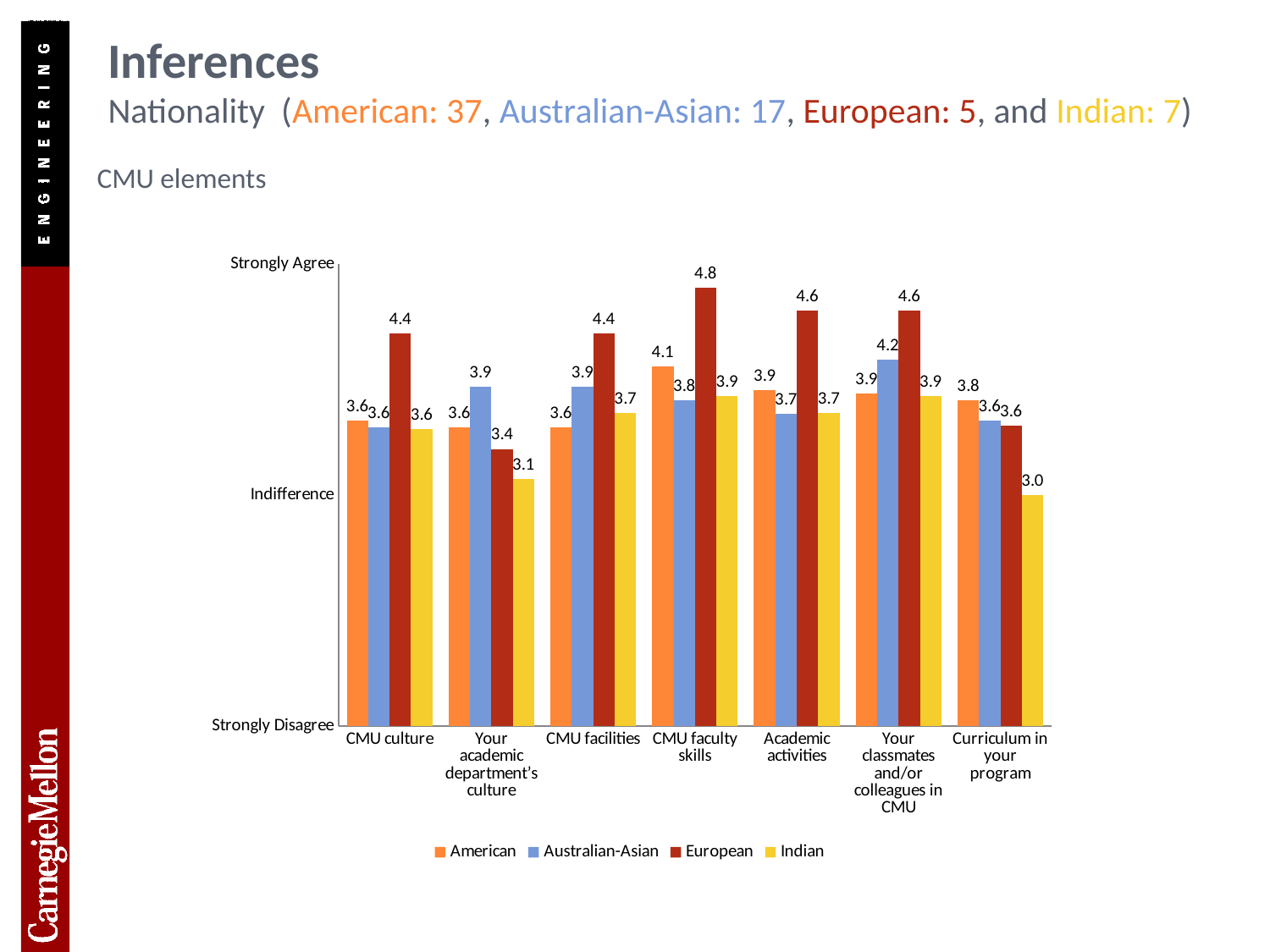
What is the Indian value for Curriculum in your program? 3.0 How many series does the legend list? 4 How many categories are shown on the x axis? 7 What is the European value for CMU faculty skills? 4.8 What is the difference between the European and American values for CMU facilities? 0.8 For Academic activities, which is larger: the European value or the Australian-Asian value? European What is the difference between the European and Indian values for Your academic department's culture? 0.3 Which category has the lowest Indian value? Curriculum in your program What kind of chart is shown on the slide? Bar chart Which category has the highest European value? CMU faculty skills What is the American value for CMU faculty skills? 4.1 What is the Australian-Asian value for Your classmates and/or colleagues in CMU? 4.2